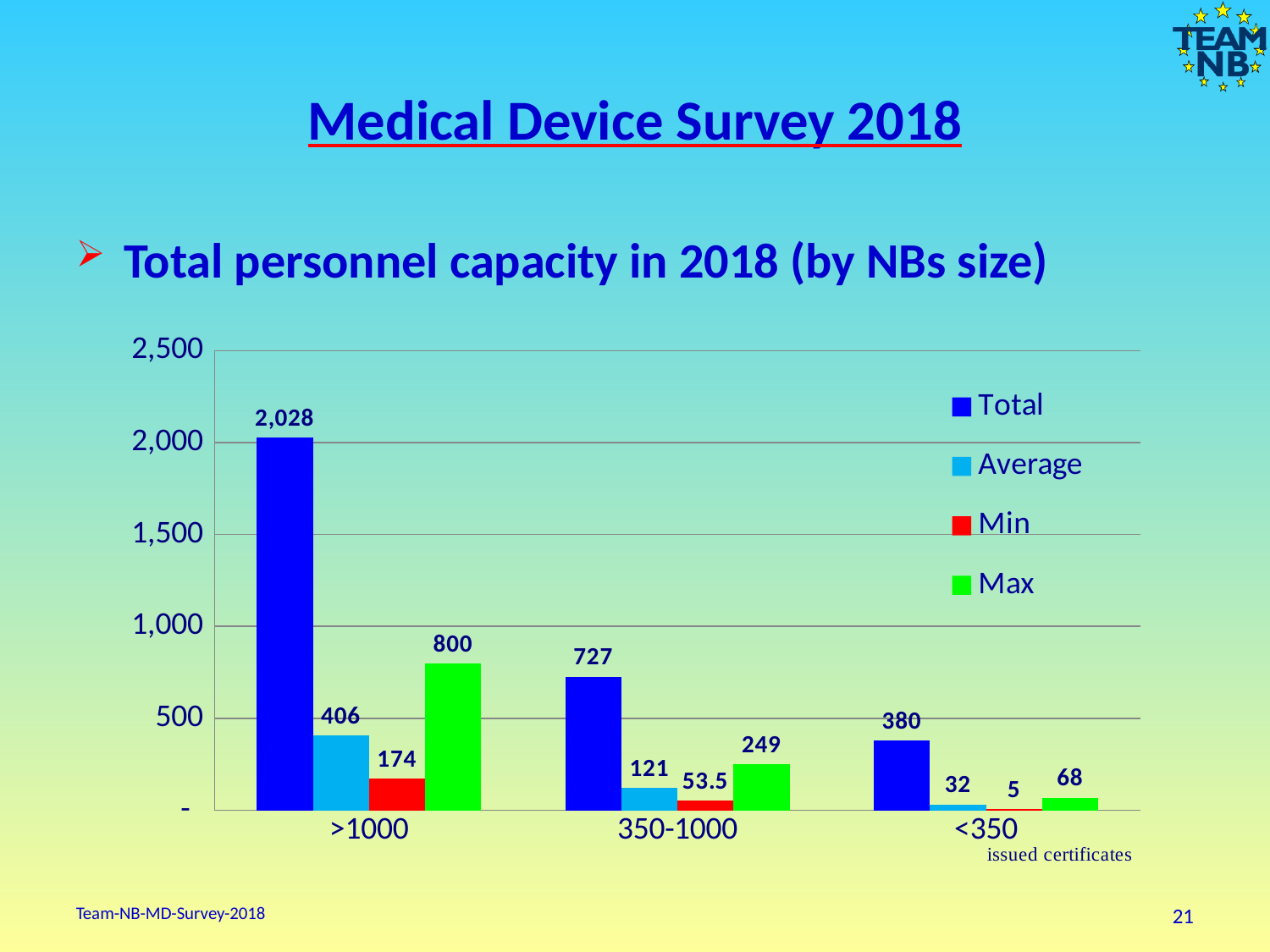
How many categories are shown on the x axis? 3 What is the Max value for the 350-1000 category? 249 How many series does the legend list? 4 What is the Min value for the <350 category? 5 Which colour represents the Min series in the legend? Red Which category has the lowest Max value? <350 What is the difference between the Total values for >1000 and 350-1000? 1,301 What kind of chart is shown on the slide? Bar chart What is the Average value for the 350-1000 category? 121 What is the Total value for the >1000 category? 2,028 Which category has the highest Total value? >1000 Which is larger, the Max value for >1000 or the Total value for 350-1000? Max value for >1000